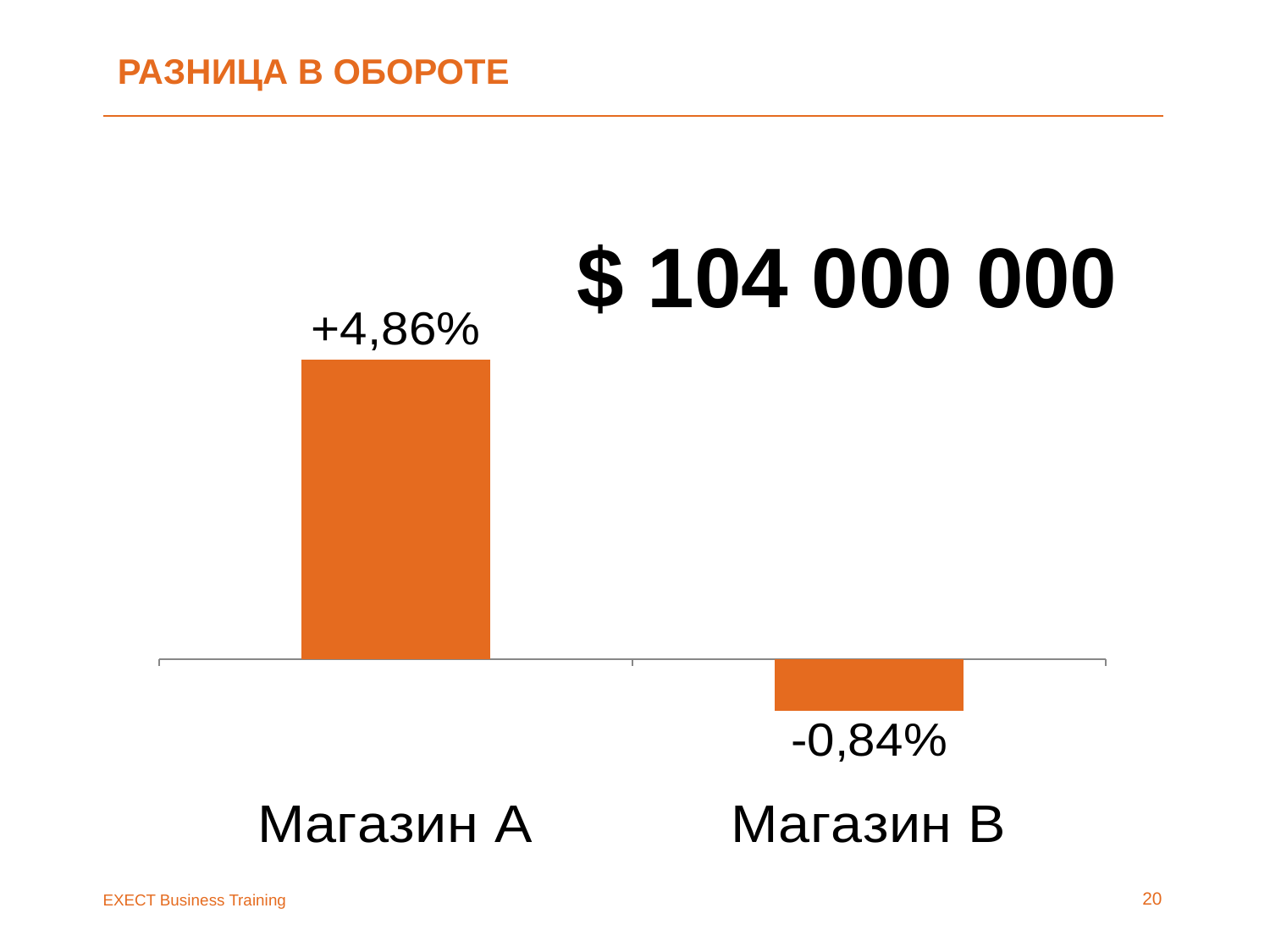
Which category has the lowest value? Магазин В Which is larger, the value for Магазин А or for Магазин В? Магазин А Which category has the highest value? Магазин А What kind of chart is shown on the slide? Bar chart Is the value for Магазин В positive or negative? Negative What is the value shown for Магазин В? -0,84% Do the values rise or fall from Магазин А to Магазин В? Fall What is the title of the slide containing the chart? РАЗНИЦА В ОБОРОТЕ How many categories are shown in the chart? 2 What is the value shown for Магазин А? +4,86% What dollar amount is printed next to the chart? $ 104 000 000